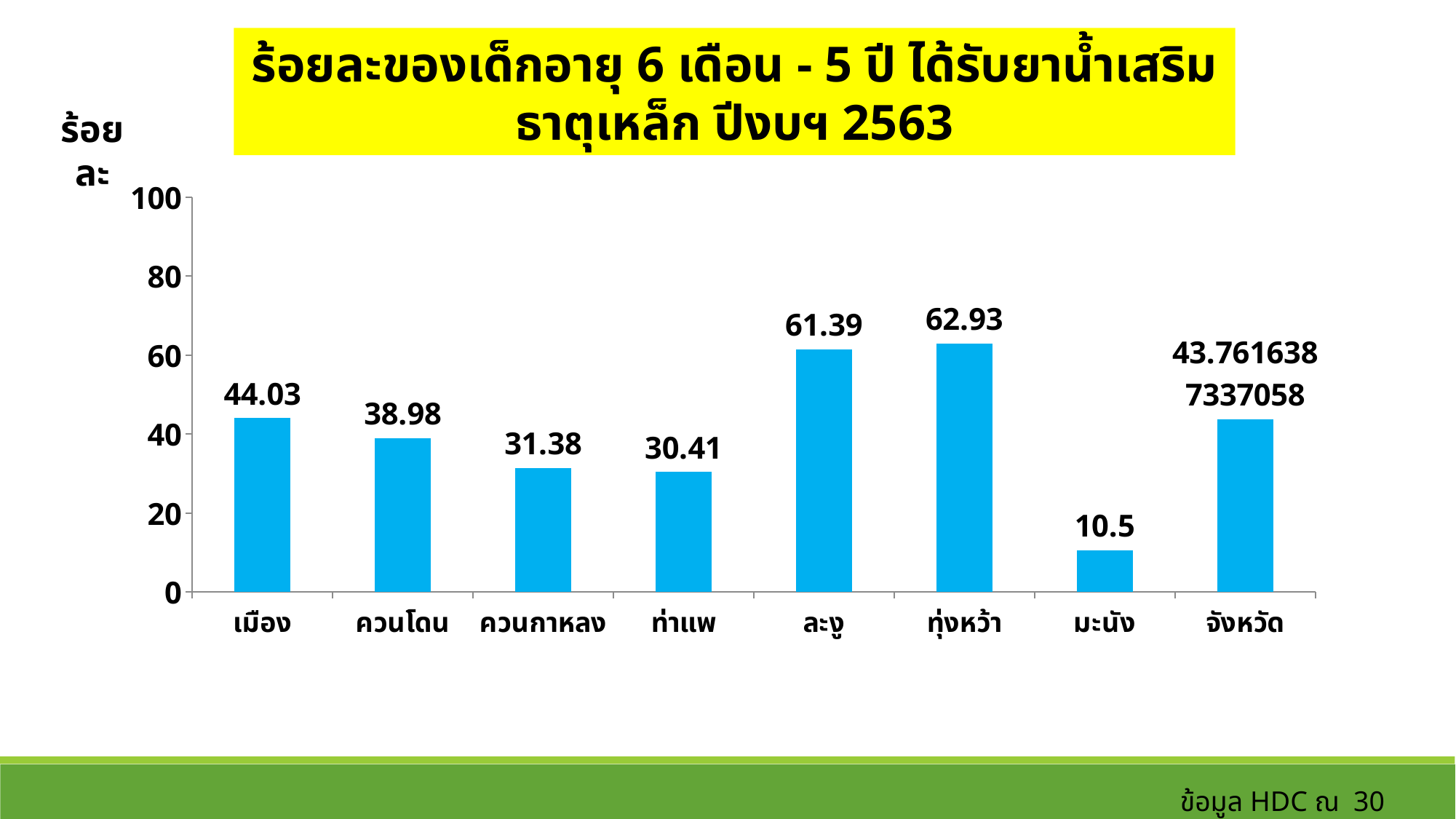
What is the difference between the values for ทุ่งหว้า and ละงู? 1.54 What is the value for ละงู? 61.39 Which category has the highest value? ทุ่งหว้า What is the label on the y axis? ร้อยละ Which is larger, the value for ควนโดน or the value for ควนกาหลง? ควนโดน What is the value for เมือง? 44.03 What is the value for ท่าแพ? 30.41 Is the value for ละงู greater or less than 60? greater How many categories are shown on the x axis? 8 Which category has the lowest value? มะนัง What is the value for มะนัง? 10.5 What kind of chart is shown on the slide? bar chart